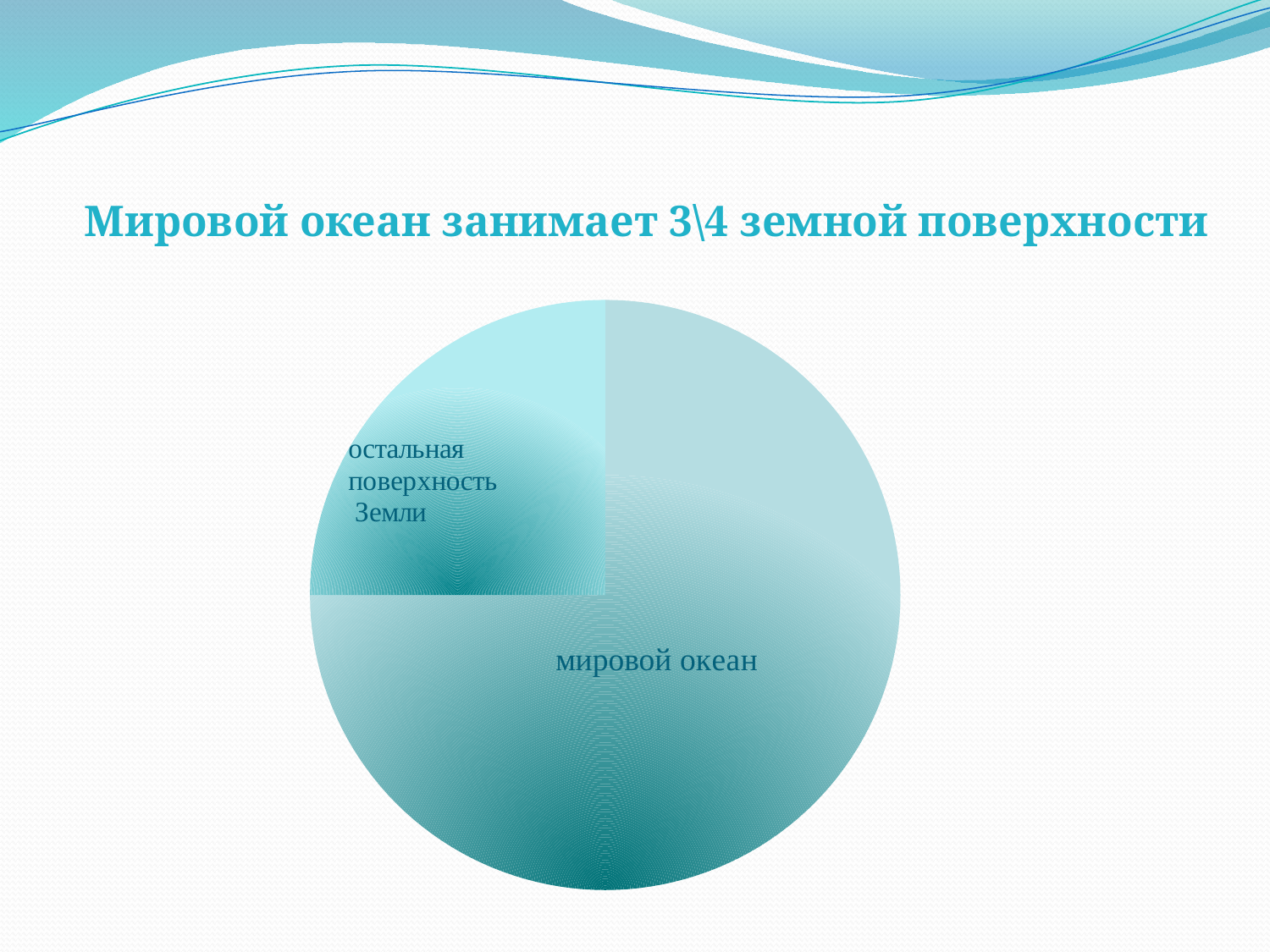
What is the label of the smaller slice of the pie chart? остальная поверхность Земли How many slices does the pie chart have? 2 What is the title of the slide with the pie chart? Мировой океан занимает 3\4 земной поверхности According to the slide, what share of the Earth's surface does мировой океан occupy? 3\4 What kind of chart is shown on the slide? pie chart Which slice of the pie chart is the smallest? остальная поверхность Земли Which slice is larger: мировой океан or остальная поверхность Земли? мировой океан Which slice of the pie chart is the largest? мировой океан